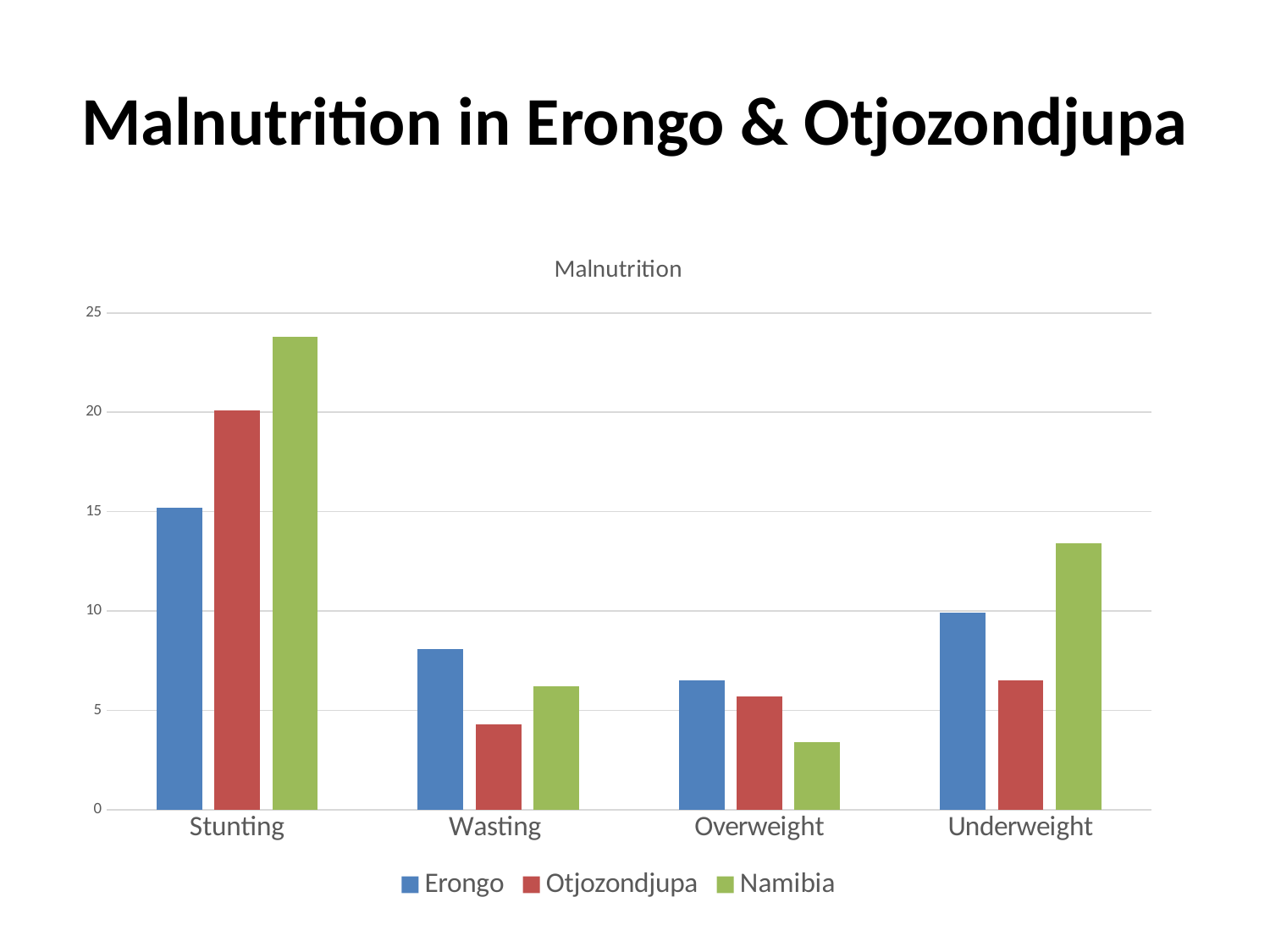
Is the value for Otjozondjupa in the Wasting category greater or less than 5? less Which series has the highest value in the Stunting category? Namibia Which category has the highest value for Namibia? Stunting Is the value for Namibia in the Underweight category greater or less than 10? greater How many categories are shown on the x axis? 4 Which category has the lowest value for Otjozondjupa? Wasting Which category has the lowest value for Namibia? Overweight What kind of chart is shown on the slide? bar chart What is the title of the chart? Malnutrition How many series does the legend list? 3 Is the value for Namibia in the Stunting category greater or less than 20? greater In the Overweight category, which is larger: the value for Erongo or the value for Namibia? Erongo